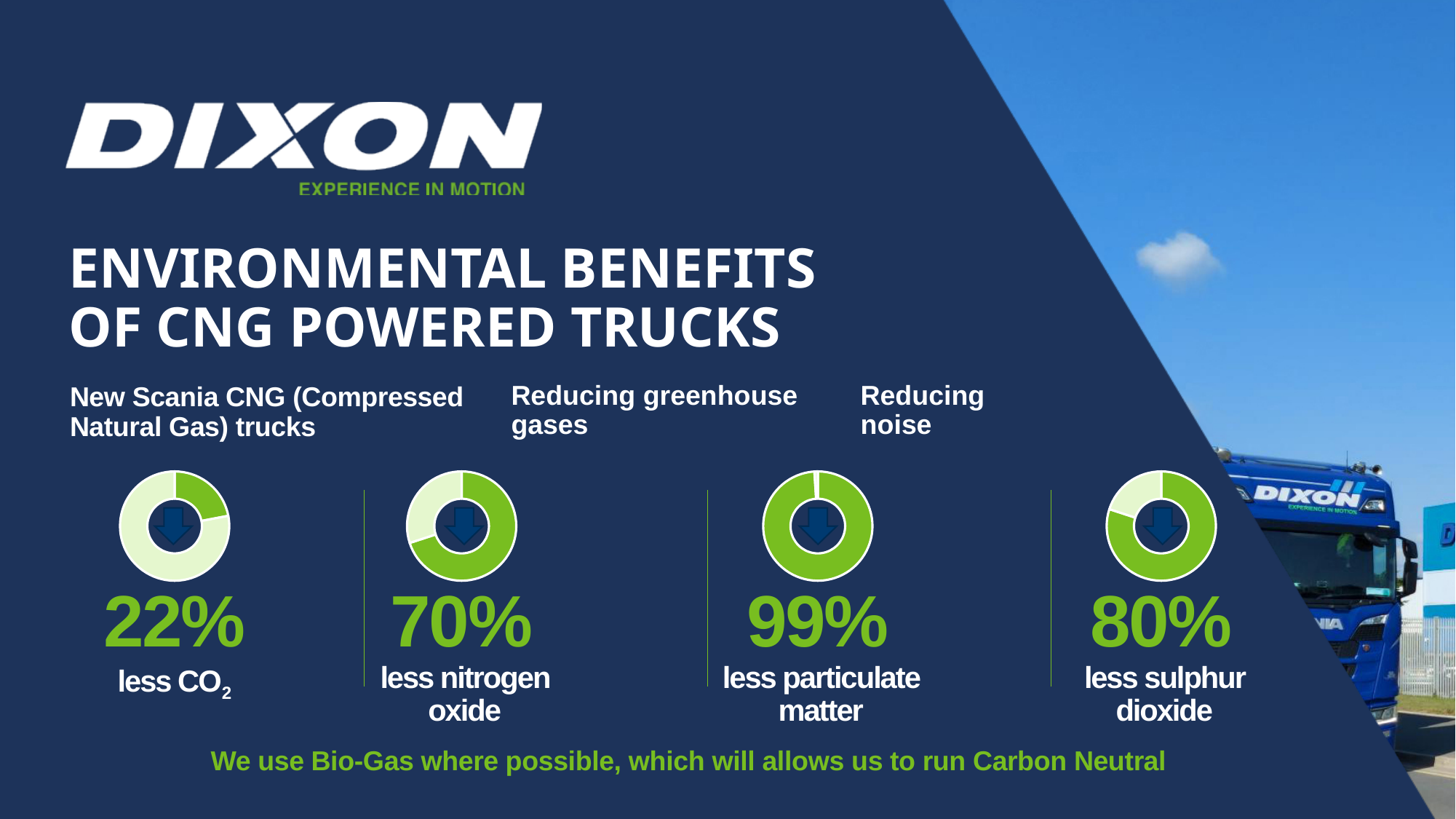
What is the difference between the particulate matter reduction and the CO2 reduction? 77% Which is larger, the reduction in nitrogen oxide or the reduction in sulphur dioxide? sulphur dioxide What kind of chart is used to show each percentage reduction? donut chart What is the title of the slide containing the charts? Environmental Benefits of CNG Powered Trucks What percentage reduction in CO2 is shown on the slide? 22% What percentage reduction in nitrogen oxide is shown on the slide? 70% Which pollutant shows the largest percentage reduction? particulate matter What is the difference between the sulphur dioxide reduction and the nitrogen oxide reduction? 10% Which pollutant shows the smallest percentage reduction? CO2 What percentage reduction in sulphur dioxide is shown on the slide? 80% How many donut charts are shown on the slide? 4 What percentage reduction in particulate matter is shown on the slide? 99%